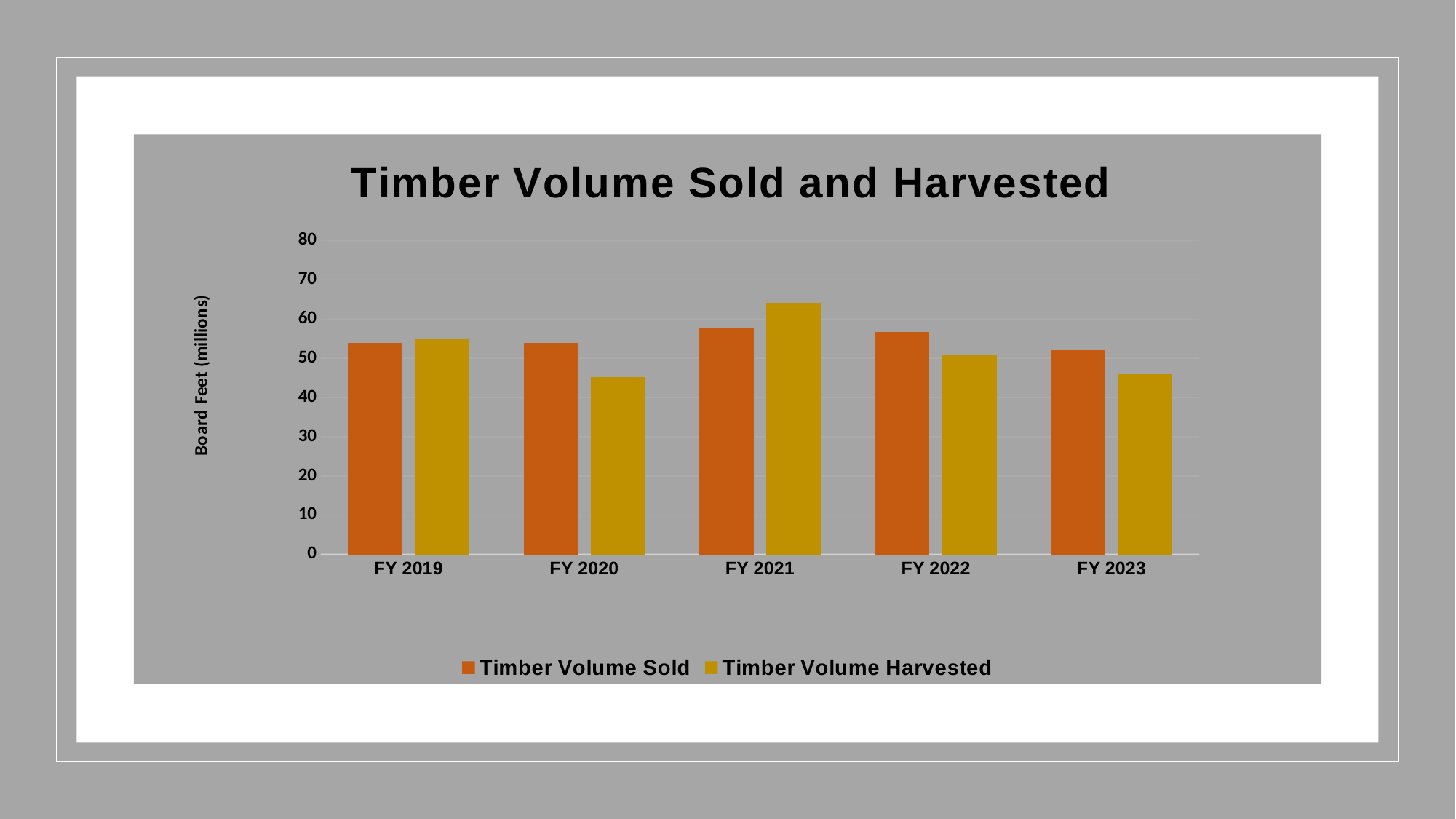
What kind of chart is shown on the slide? bar chart What is the label of the vertical axis? Board Feet (millions) In FY 2020, which is larger: Timber Volume Sold or Timber Volume Harvested? Timber Volume Sold In FY 2021, which is larger: Timber Volume Sold or Timber Volume Harvested? Timber Volume Harvested Is the Timber Volume Harvested value for FY 2021 greater or less than 60? greater How many series does the legend list? 2 In which fiscal year is Timber Volume Harvested the lowest? FY 2020 What is the title of the chart? Timber Volume Sold and Harvested How many fiscal years are shown on the x axis? 5 In which fiscal year is Timber Volume Harvested the highest? FY 2021 Is the Timber Volume Harvested value for FY 2020 greater or less than 50? less